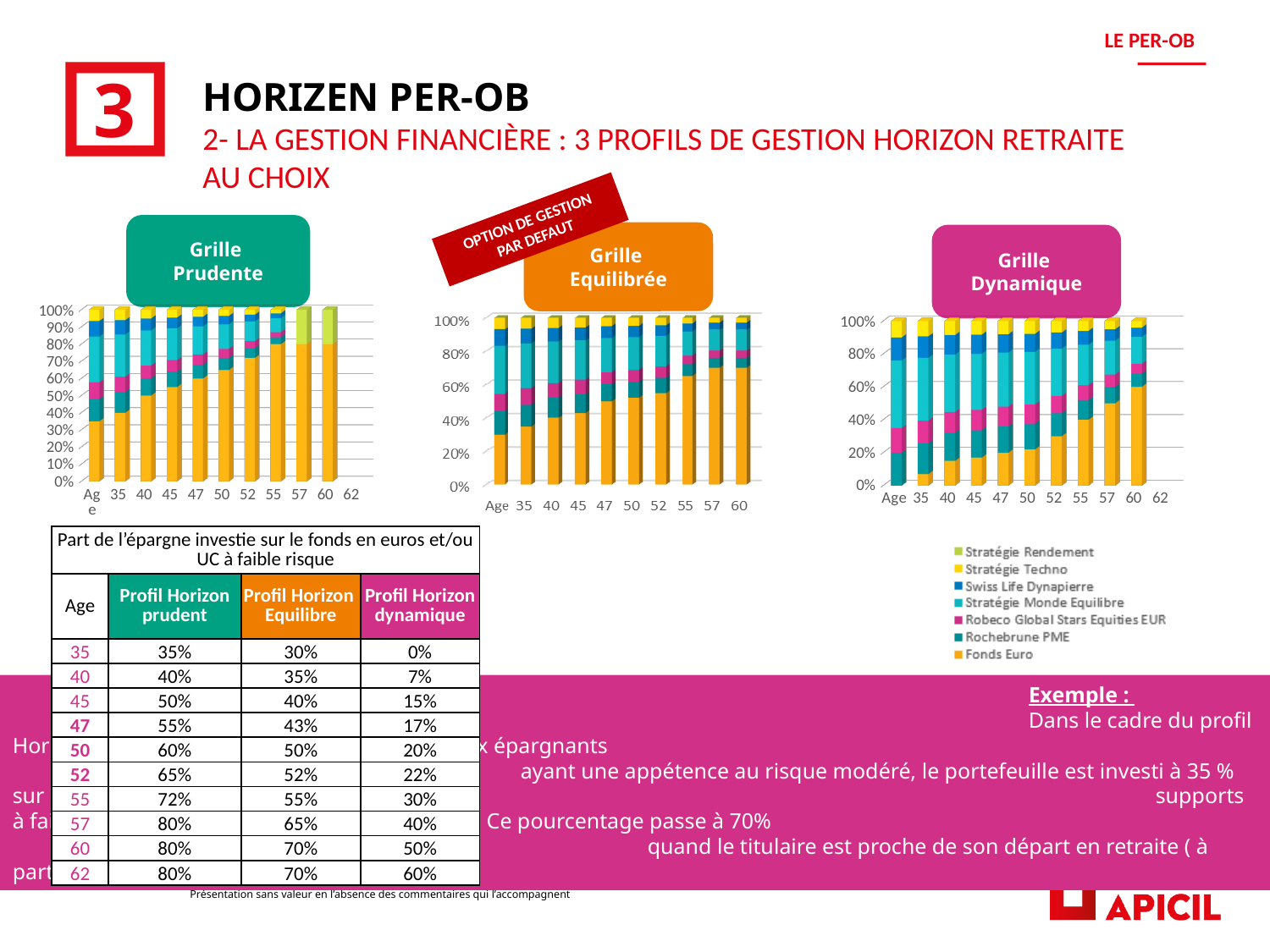
Which of the three charts is marked as the default management option (OPTION DE GESTION PAR DEFAUT)? Grille Equilibrée In the Grille Equilibrée chart, is the Fonds Euro share at age 60 greater or less than 60%? greater In the Grille Dynamique chart, which age has the smallest Fonds Euro share? 35 In the Grille Equilibrée chart, does the Fonds Euro share rise or fall as age increases? rise How many series does the legend list for the charts? 7 In the Grille Dynamique chart, is the Fonds Euro share at age 35 greater or less than 20%? less Which series is listed last in the legend? Fonds Euro At age 35, which chart shows a larger Fonds Euro share, Grille Prudente or Grille Dynamique? Grille Prudente In the Grille Prudente chart, is the Fonds Euro share at age 60 greater or less than 70%? greater In the Grille Equilibrée chart, which age has the smallest Fonds Euro share? 35 What kind of chart is the Grille Prudente chart? stacked bar chart